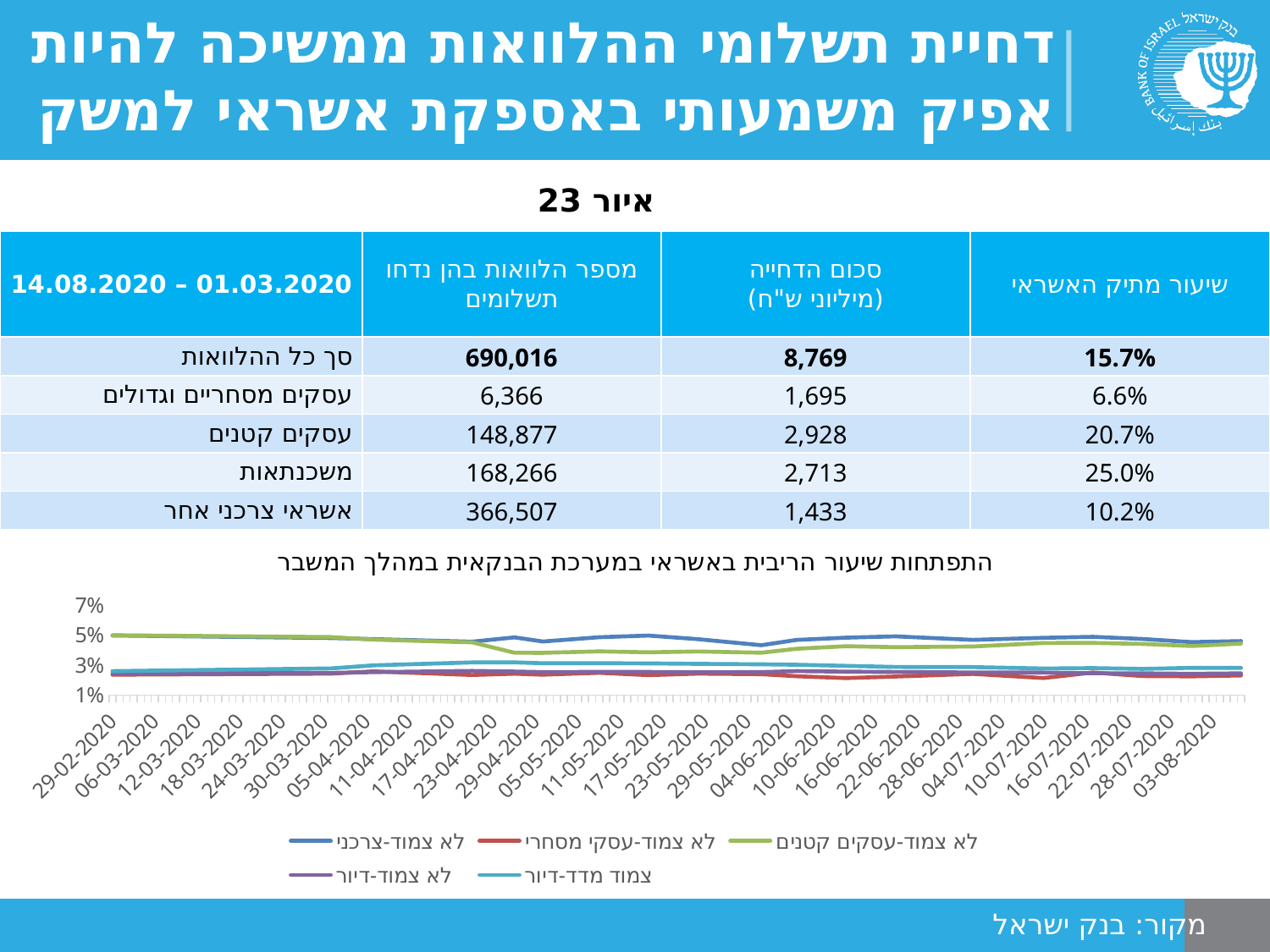
In the line chart, is the value of the לא צמוד-עסקי מסחרי series at 03-08-2020 greater or less than 3%? less What is the title of the line chart? התפתחות שיעור הריבית באשראי במערכת הבנקאית במהלך המשבר In the line chart, does the לא צמוד-צרכני series rise or fall from 29-02-2020 to 03-08-2020? fall What kind of chart is shown at the bottom of the slide? line chart In the line chart, is the value of the לא צמוד-צרכני series at 29-02-2020 greater or less than 3%? greater In the line chart, is the value of the לא צמוד-צרכני series at 03-08-2020 greater or less than 3%? greater What is the highest tick value shown on the y axis of the line chart? 7% How many series does the legend of the line chart list? 5 In the line chart, does the לא צמוד-עסקים קטנים series rise or fall from 29-02-2020 to 03-08-2020? fall